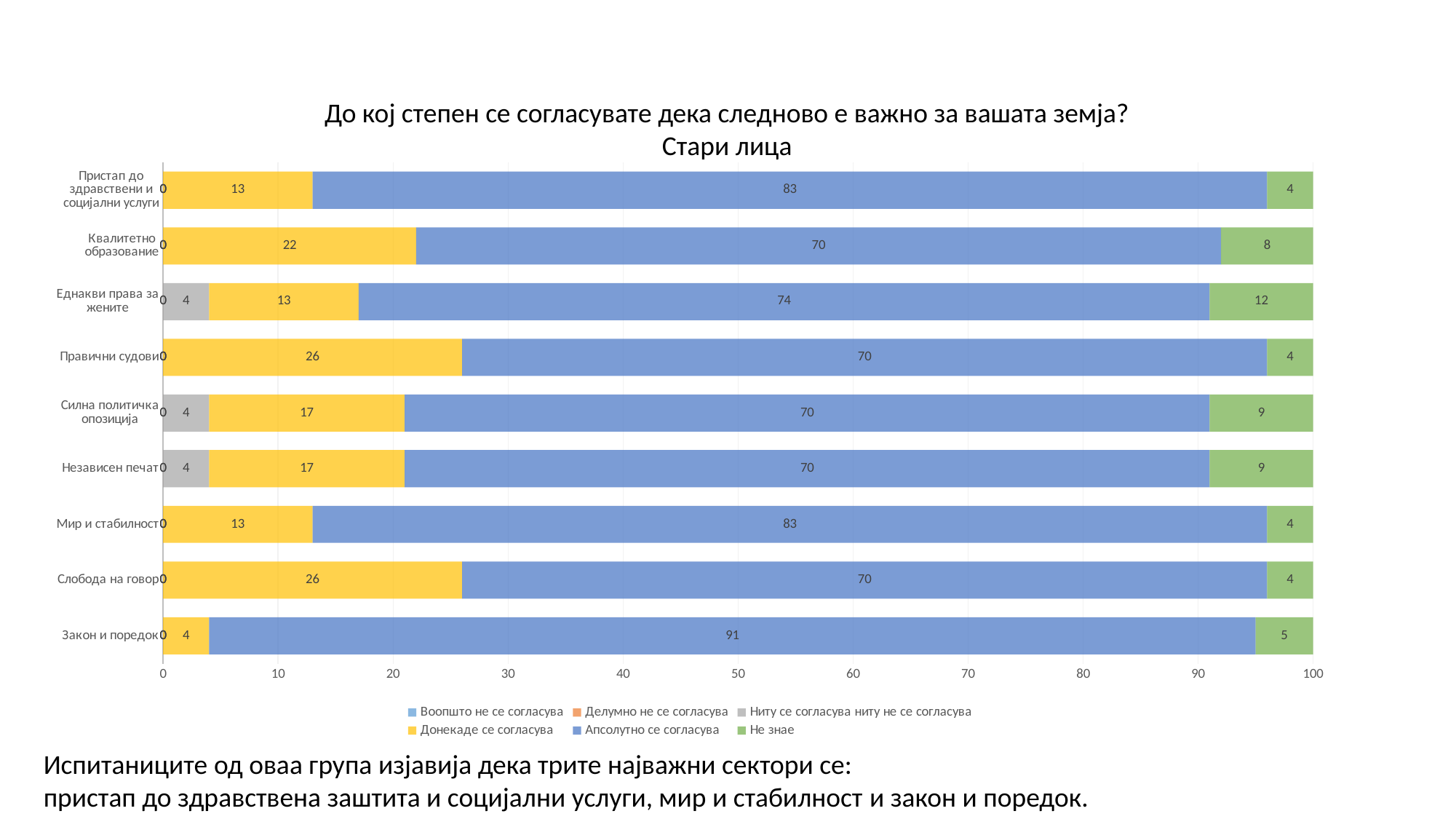
What is the total of the stacked bar for 'Пристап до здравствени и социјални услуги'? 100 Which is larger: the 'Донекаде се согласува' value for 'Правични судови' or for 'Силна политичка опозиција'? Правични судови Which category has the highest value for 'Не знае'? Еднакви права за жените How many categories are shown on the chart? 9 Which category has the highest value for 'Апсолутно се согласува'? Закон и поредок How many series does the legend list? 6 What is the value of 'Донекаде се согласува' for 'Квалитетно образование'? 22 What is the value of 'Не знае' for 'Еднакви права за жените'? 12 Is the 'Апсолутно се согласува' value for 'Закон и поредок' greater or less than 90? greater What is the value of 'Апсолутно се согласува' for 'Закон и поредок'? 91 What kind of chart is shown on the slide? Stacked bar chart What is the difference between the 'Апсолутно се согласува' values for 'Мир и стабилност' and 'Слобода на говор'? 13